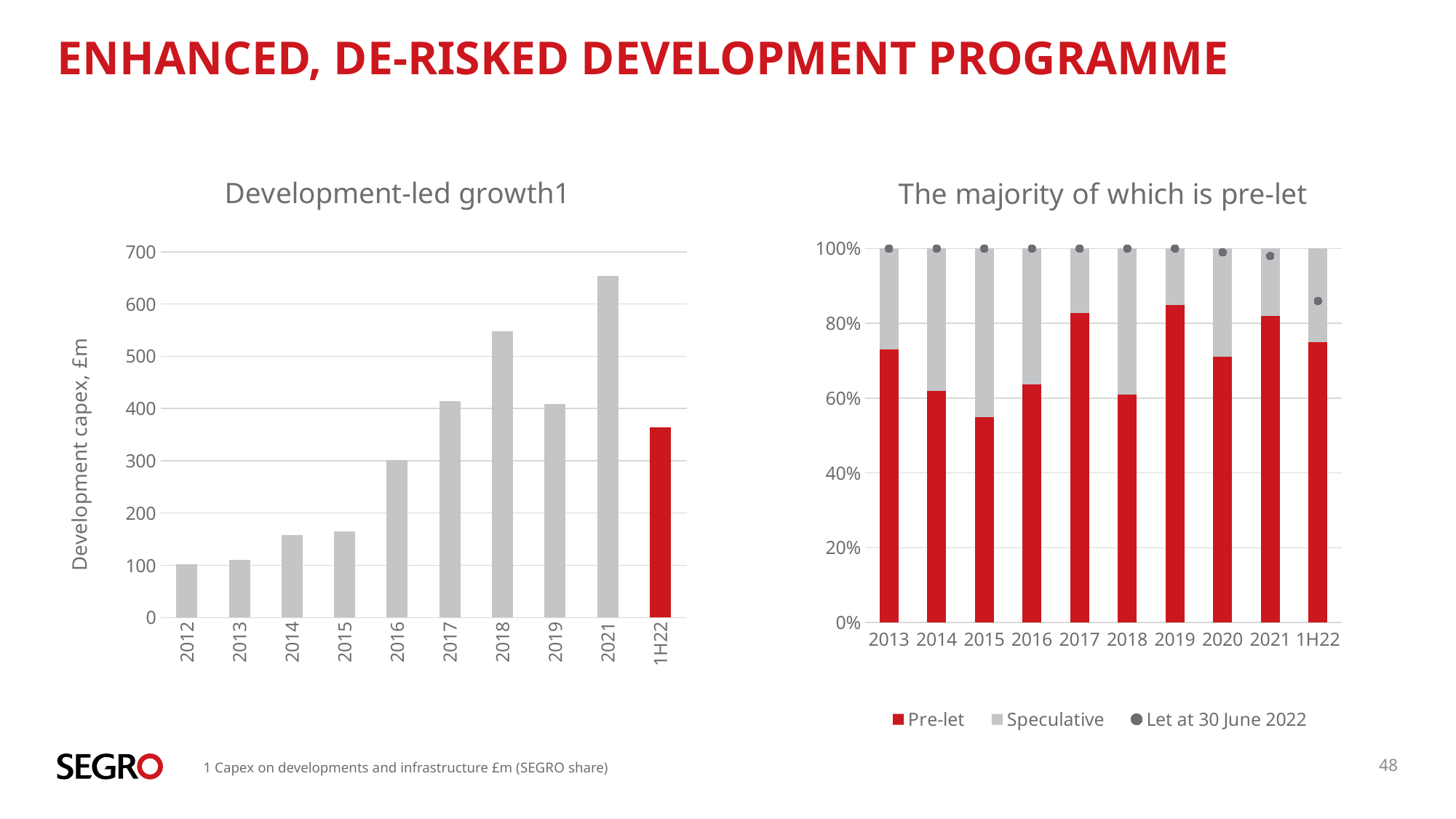
What kind of chart is 'Development-led growth1'? bar chart On the chart 'The majority of which is pre-let', is the Pre-let value for 2019 greater or less than 80%? greater On the chart 'The majority of which is pre-let', which year has the lowest Pre-let share? 2015 On the 'Development-led growth1' chart, which year has the lowest development capex? 2012 On the 'Development-led growth1' chart, which year has the highest development capex? 2021 On the 'Development-led growth1' chart, which is larger, the value for 2018 or the value for 2019? 2018 How many series does the legend list on the chart 'The majority of which is pre-let'? 3 On the 'Development-led growth1' chart, is the value for 2021 greater or less than 600? greater How many bars are shown on the 'Development-led growth1' chart? 10 On the 'Development-led growth1' chart, is the value for 1H22 greater or less than 400? less On the 'Development-led growth1' chart, what is the label of the vertical axis? Development capex, £m